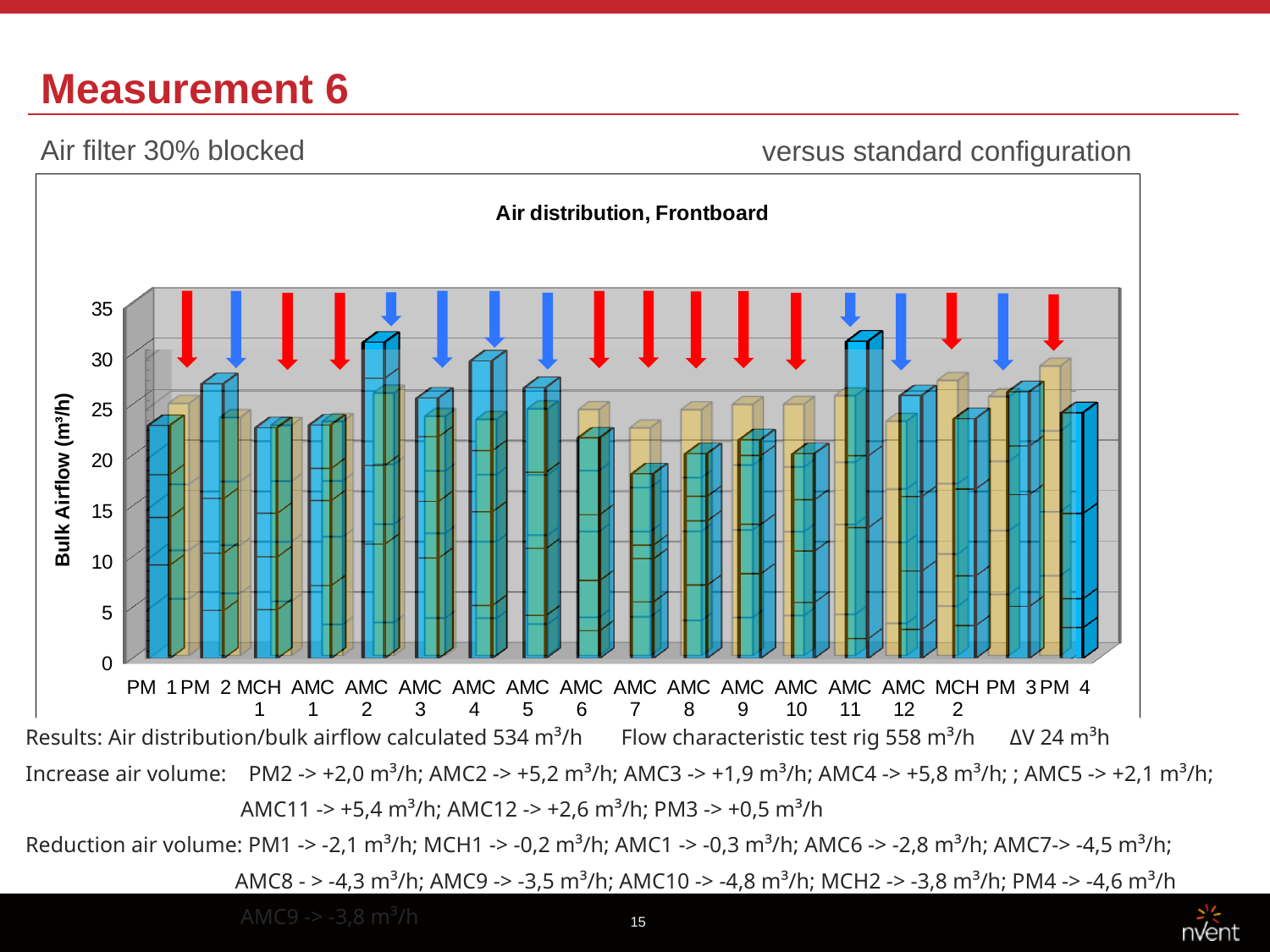
Which has the larger blue bar, AMC 11 or AMC 9? AMC 11 What is the title of the chart? Air distribution, Frontboard How many categories are shown along the x axis of the chart? 18 Which category has the lowest blue bar in the chart? AMC 7 Is the blue bar for AMC 2 greater or less than 30? greater Which has the larger blue bar, AMC 2 or AMC 7? AMC 2 Is the blue bar for AMC 7 greater or less than 20? less Is the blue bar for PM 1 greater or less than 20? greater What type of chart is shown on the slide? bar chart What is the label of the vertical axis of the chart? Bulk Airflow (m³/h)